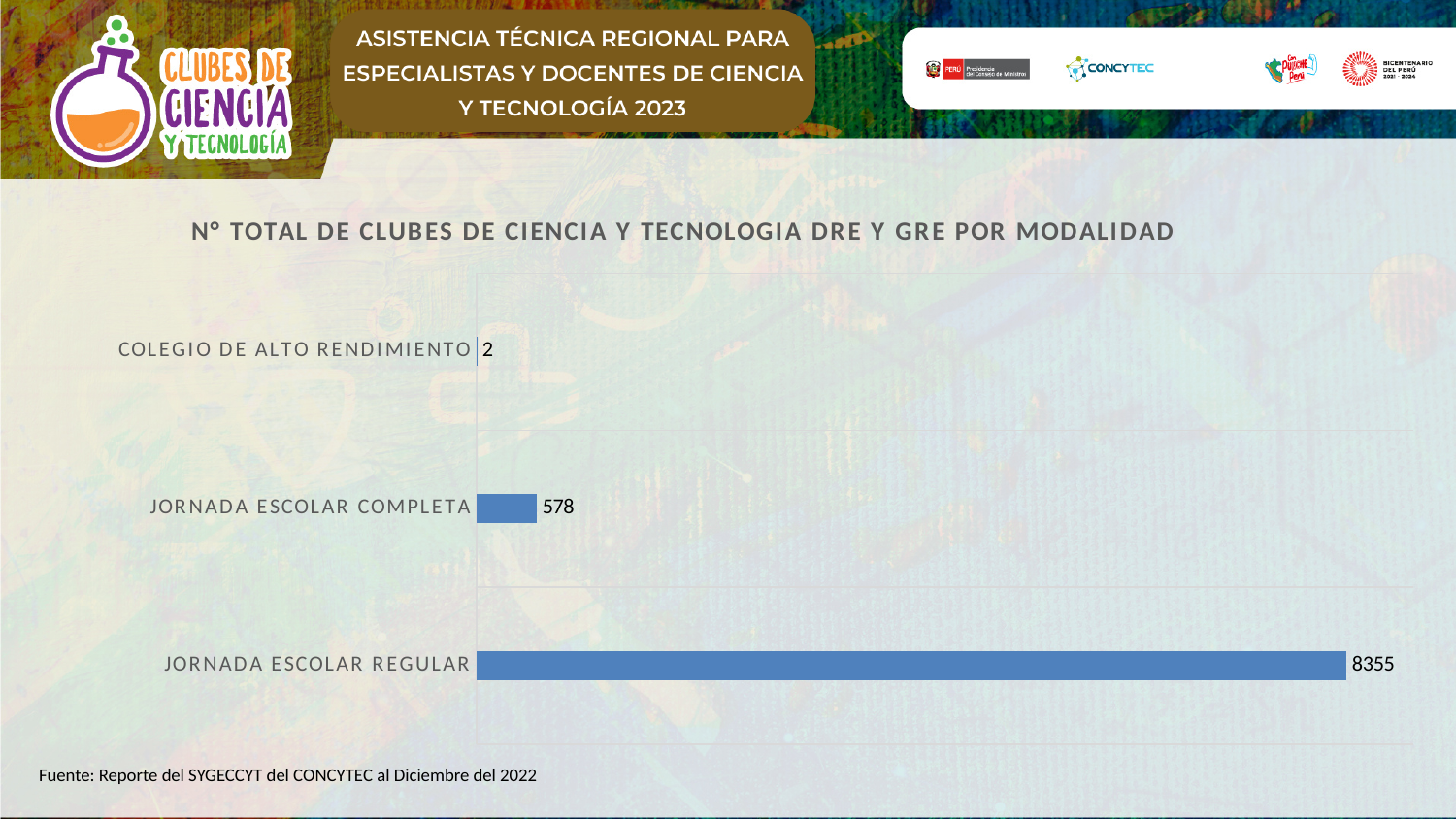
What is the value for COLEGIO DE ALTO RENDIMIENTO? 2 What is the title of the chart? N° TOTAL DE CLUBES DE CIENCIA Y TECNOLOGIA DRE Y GRE POR MODALIDAD Which category has the highest value? JORNADA ESCOLAR REGULAR Which is larger, the value for JORNADA ESCOLAR COMPLETA or the value for COLEGIO DE ALTO RENDIMIENTO? JORNADA ESCOLAR COMPLETA What is the difference between the values for JORNADA ESCOLAR REGULAR and JORNADA ESCOLAR COMPLETA? 7777 Which category has the lowest value? COLEGIO DE ALTO RENDIMIENTO What is the difference between the values for JORNADA ESCOLAR COMPLETA and COLEGIO DE ALTO RENDIMIENTO? 576 What is the value for JORNADA ESCOLAR REGULAR? 8355 What kind of chart is shown on the slide? Bar chart What is the total of the three values shown in the chart? 8935 How many categories are shown in the chart? 3 What is the value for JORNADA ESCOLAR COMPLETA? 578